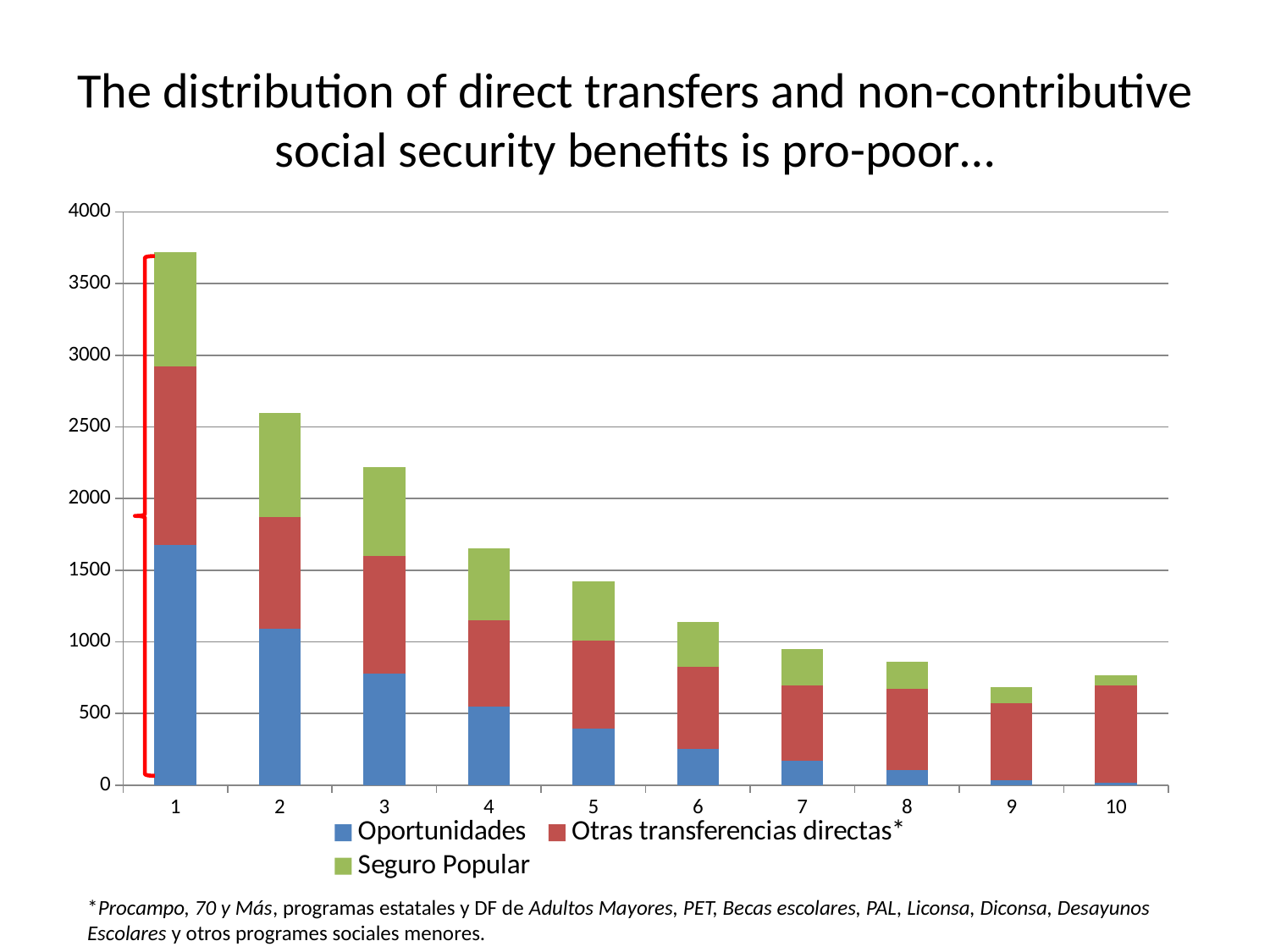
Which has the larger total stacked bar, category 1 or category 2? 1 What kind of chart is shown on the slide? stacked bar chart Is the Oportunidades value for category 1 greater or less than 1500? greater How many categories are shown along the x axis of the chart? 10 Which category has the highest total stacked bar? 1 Is the total stacked value for category 1 greater or less than 3500? greater Is the total stacked value for category 10 greater or less than 1000? less Which category has the smallest Oportunidades segment? 10 Which series is shown in green in the chart's legend? Seguro Popular Which has the larger Oportunidades segment, category 2 or category 3? 2 How many series does the chart's legend list? 3 Do the total bar heights generally rise or fall from category 1 to category 10? fall